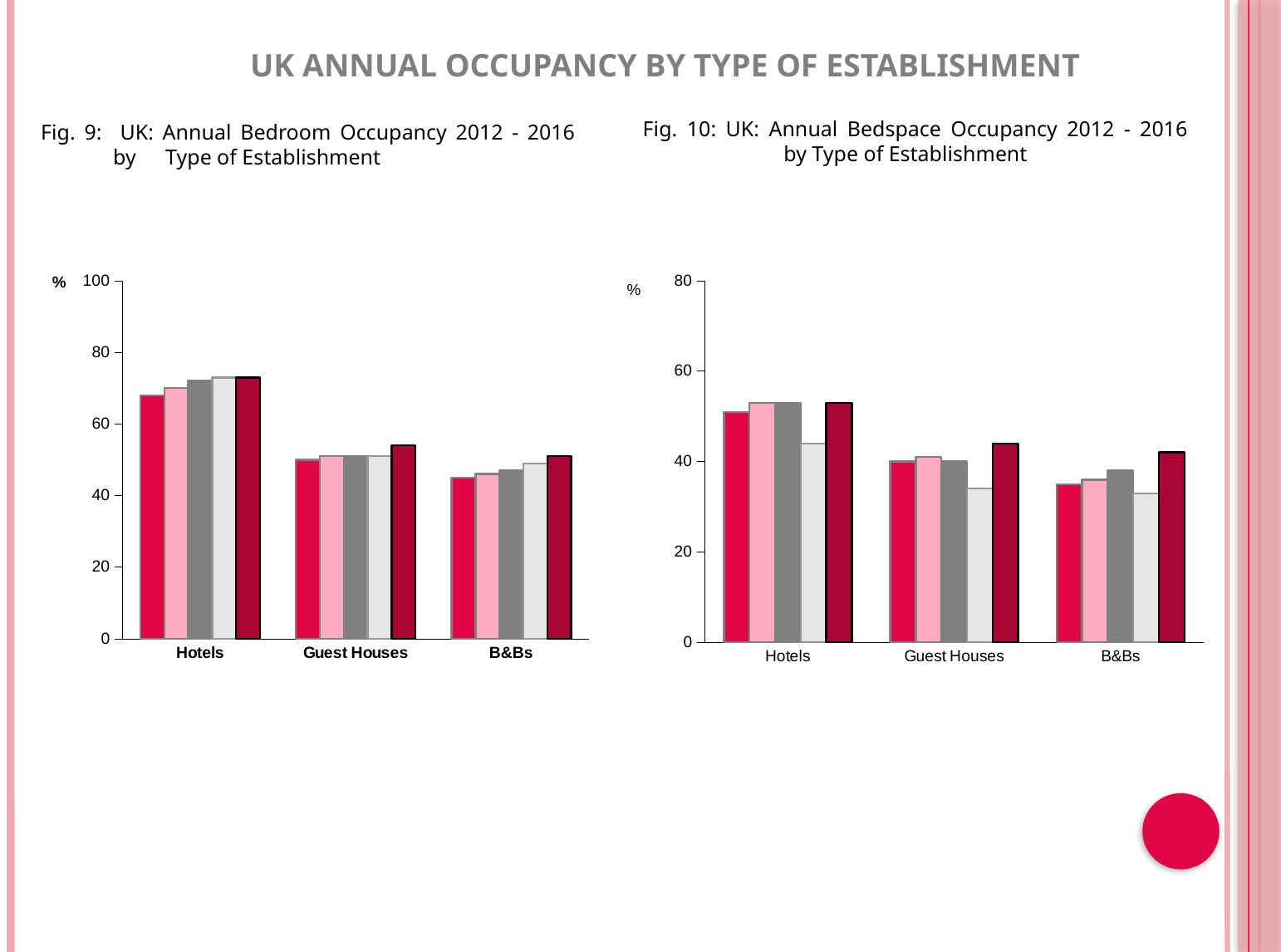
In Fig. 10 (Annual Bedspace Occupancy), which type of establishment has the lowest occupancy? B&Bs In Fig. 10 (Annual Bedspace Occupancy), which type of establishment has the highest occupancy? Hotels In Fig. 10 (Annual Bedspace Occupancy), are the bars for B&Bs greater or less than 20? greater In Fig. 9 (Annual Bedroom Occupancy), which type of establishment has the lowest occupancy? B&Bs In Fig. 9 (Annual Bedroom Occupancy), are the bars for Hotels greater or less than 60? greater In Fig. 10 (Annual Bedspace Occupancy), are the bars for Hotels greater or less than 60? less In Fig. 9 (Annual Bedroom Occupancy), what is the maximum value shown on the vertical axis? 100 In Fig. 9 (Annual Bedroom Occupancy), what kind of chart is shown? bar chart In Fig. 10 (Annual Bedspace Occupancy), how many establishment types are shown on the x axis? 3 In Fig. 10 (Annual Bedspace Occupancy), which has higher occupancy, Hotels or Guest Houses? Hotels In Fig. 9 (Annual Bedroom Occupancy), which type of establishment has the highest occupancy? Hotels